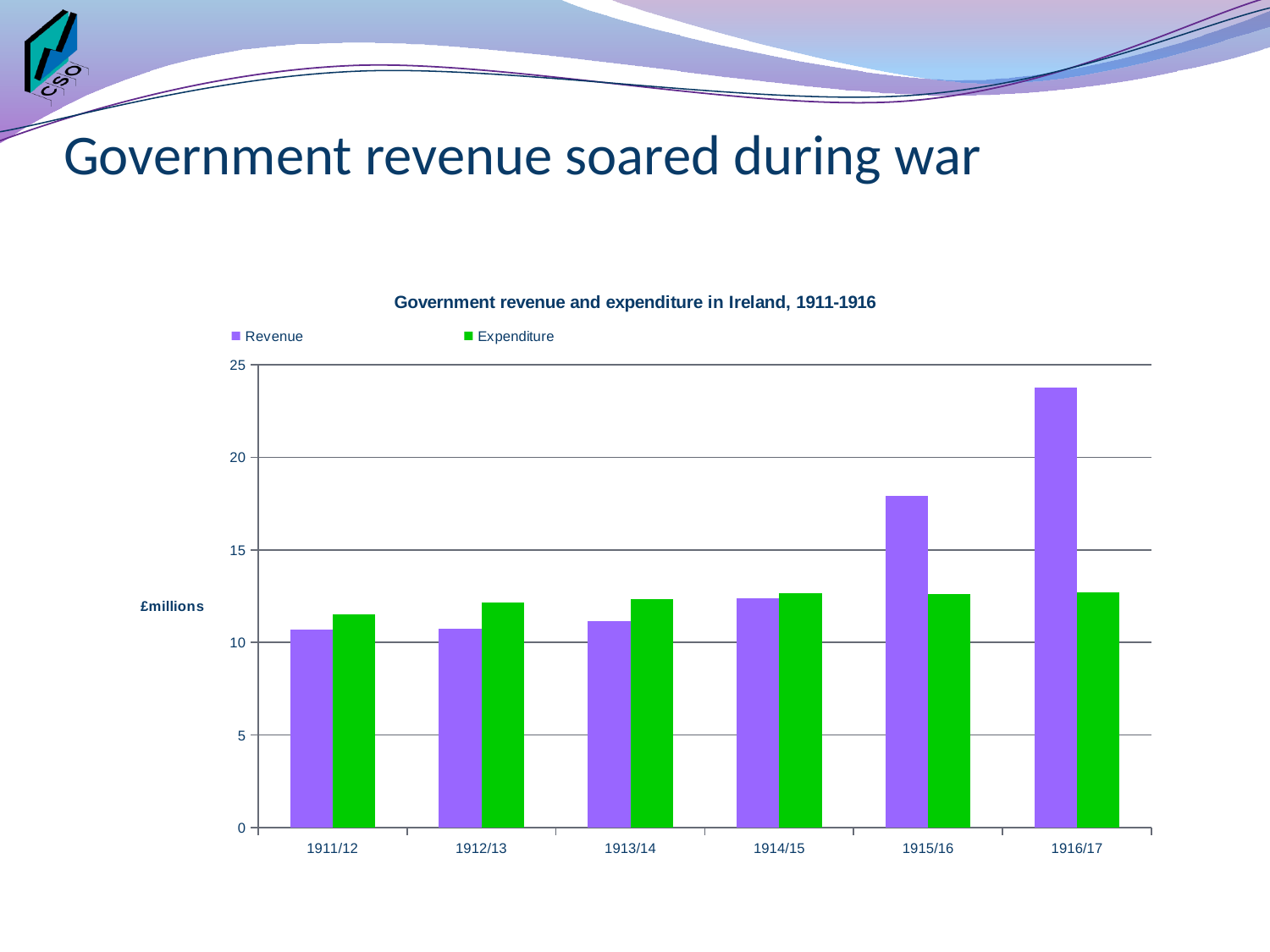
Which year has the highest Revenue? 1916/17 Is the Revenue value for 1916/17 greater or less than 20? greater Does Revenue rise or fall from 1911/12 to 1916/17? rise Is the Expenditure value for 1916/17 greater or less than 15? less How many fiscal years are shown on the x axis? 6 In 1911/12, which is larger, Revenue or Expenditure? Expenditure What kind of chart is shown on the slide? bar chart Which year has the lowest Expenditure? 1911/12 In 1916/17, which is larger, Revenue or Expenditure? Revenue How many series does the legend list? 2 Is the Revenue value for 1915/16 greater or less than 15? greater